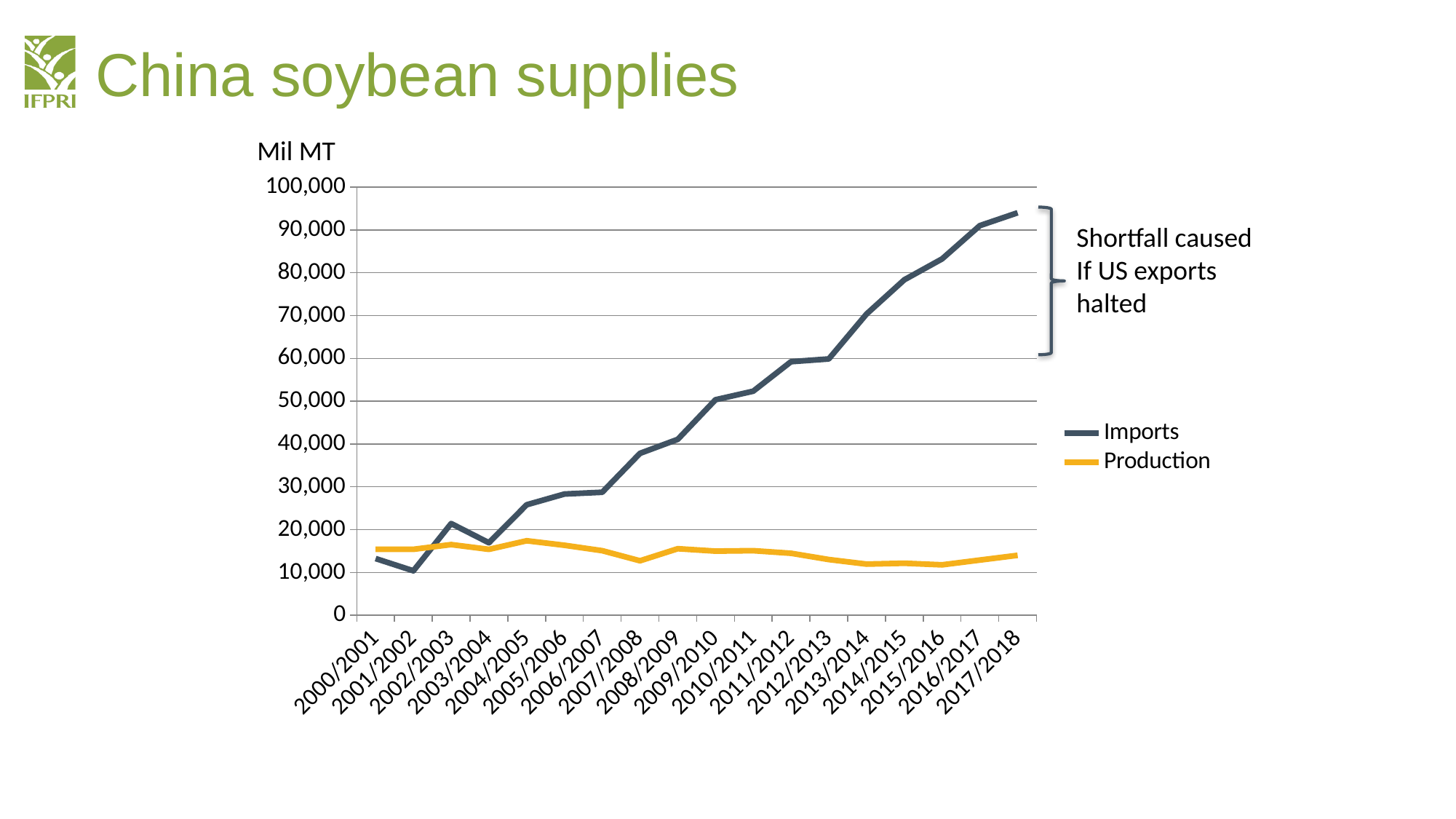
Is the Production value for 2017/2018 greater or less than 20,000? less Do the Imports values generally rise or fall from 2000/2001 to 2017/2018? rise What kind of chart is shown on the slide? line chart In which year is the Imports value highest? 2017/2018 How many series does the legend list? 2 How many marketing years are plotted along the x axis? 18 In 2017/2018, which is larger: Imports or Production? Imports In 2001/2002, which is larger: Imports or Production? Production Is the Imports value for 2014/2015 greater or less than 80,000? less What unit label is shown above the y axis? Mil MT Is the Imports value for 2017/2018 greater or less than 90,000? greater In which year is the Imports value lowest? 2001/2002